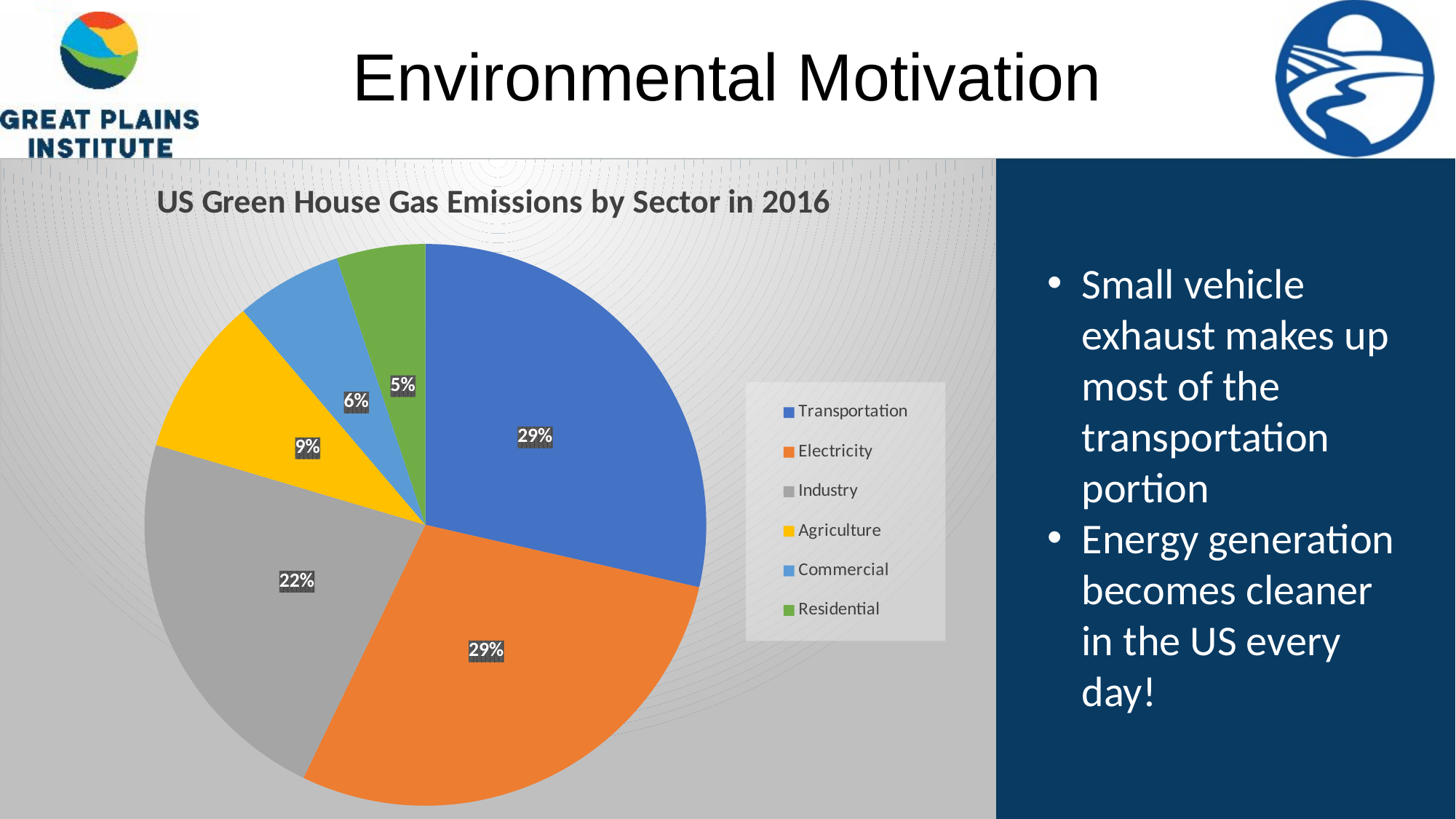
How many sectors are shown in the pie chart? 6 What share of emissions does the Transportation sector account for? 29% What share of emissions does the Commercial sector account for? 6% What type of chart is shown on the slide? pie chart What share of emissions does the Industry sector account for? 22% Which sector has a larger share, Industry or Commercial? Industry What colour represents Electricity in the pie chart? orange What is the title of the chart? US Green House Gas Emissions by Sector in 2016 What is the difference between the Industry share and the Agriculture share? 13% What share of emissions does the Agriculture sector account for? 9% Which sector has the smallest share of emissions? Residential What share of emissions does the Residential sector account for? 5%